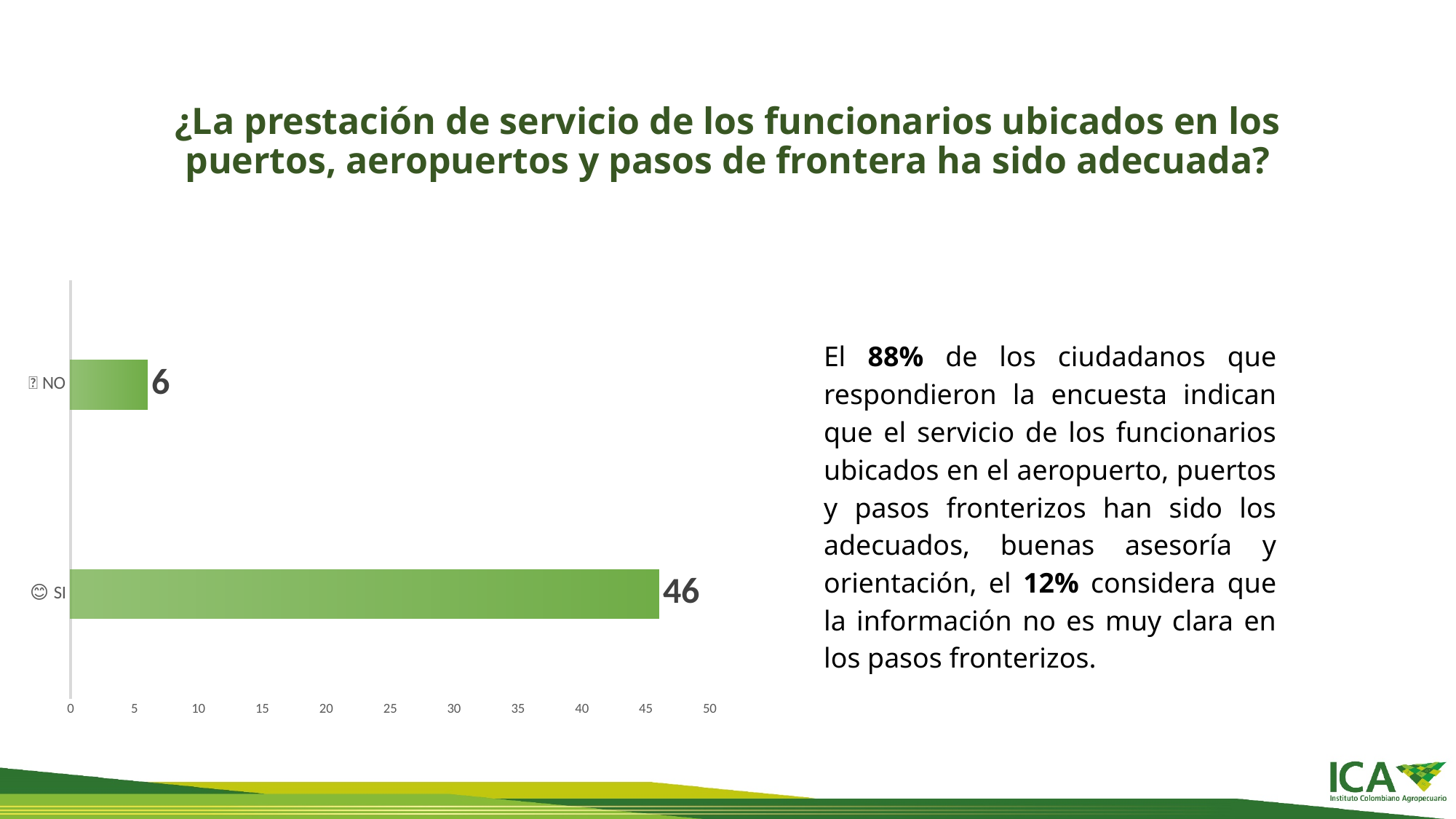
Is the value for NO greater or less than 10? less What is the highest value shown on the x axis? 50 Which category has the lowest value? NO Is the value for SI greater or less than 40? greater What is the value for SI? 46 What is the value for NO? 6 Which category has the highest value? SI What kind of chart is shown on the slide? bar chart What is the total of the values for SI and NO? 52 Which is larger, the value for SI or the value for NO? SI What is the difference between the values for SI and NO? 40 How many categories are shown in the chart? 2